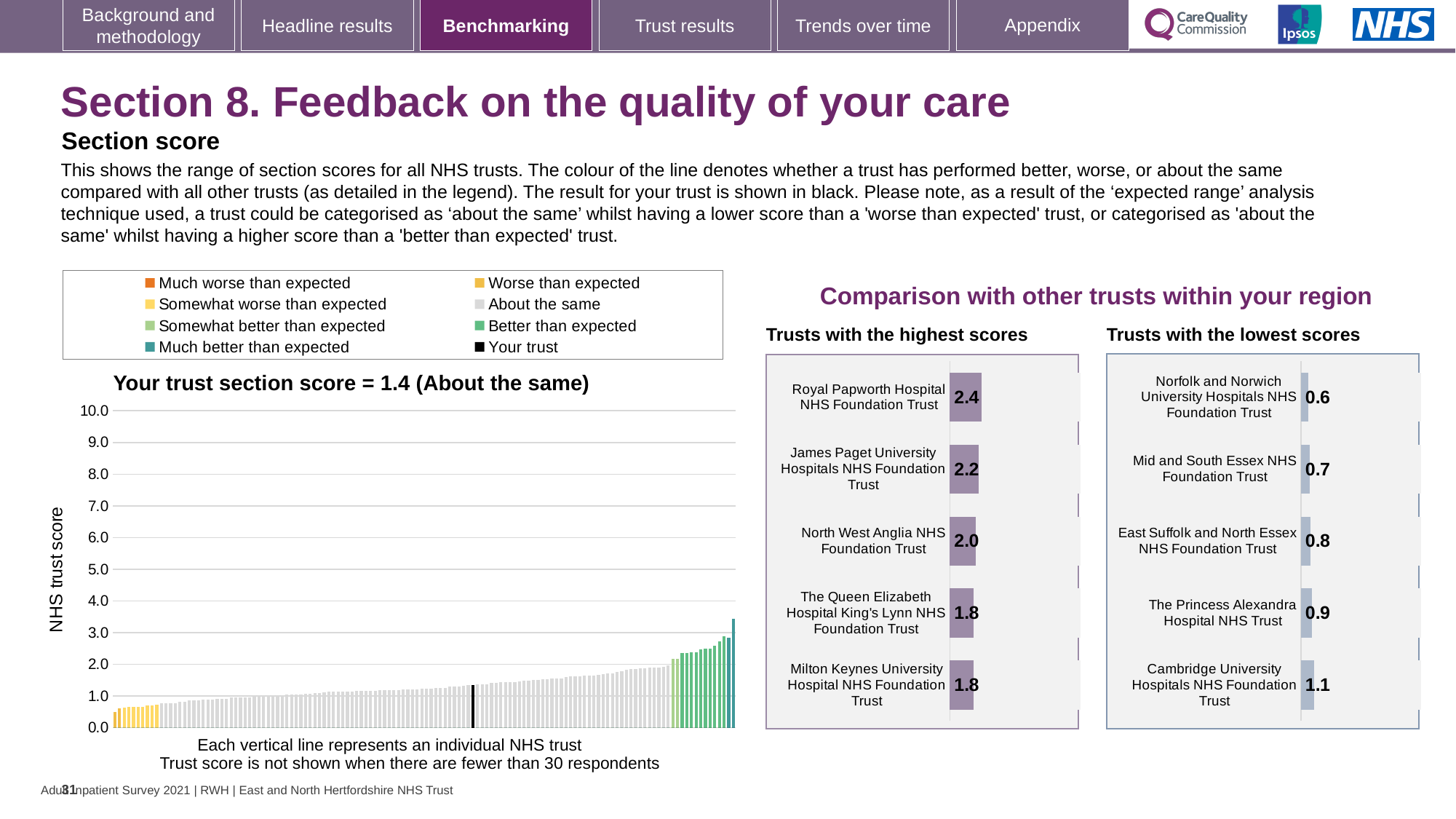
In the 'Trusts with the highest scores' chart, what is the score for Royal Papworth Hospital NHS Foundation Trust? 2.4 In the 'Trusts with the lowest scores' chart, which trust has the lowest score? Norfolk and Norwich University Hospitals NHS Foundation Trust In the 'Trusts with the lowest scores' chart, what is the score for Mid and South Essex NHS Foundation Trust? 0.7 In the main chart on the left, do the trust scores rise or fall from left to right? Rise In the 'Trusts with the highest scores' chart, what is the difference between the scores of Royal Papworth Hospital NHS Foundation Trust and James Paget University Hospitals NHS Foundation Trust? 0.2 In the 'Trusts with the lowest scores' chart, what is the difference between the scores of Cambridge University Hospitals NHS Foundation Trust and Norfolk and Norwich University Hospitals NHS Foundation Trust? 0.5 According to the title of the main chart on the left, what is your trust's section score? 1.4 (About the same) In the 'Trusts with the lowest scores' chart, which has the larger score: East Suffolk and North Essex NHS Foundation Trust or The Princess Alexandra Hospital NHS Trust? The Princess Alexandra Hospital NHS Trust In the 'Trusts with the highest scores' chart, which trust has the highest score? Royal Papworth Hospital NHS Foundation Trust How many trusts are shown in the 'Trusts with the highest scores' chart? 5 What kind of chart is the main chart on the left showing NHS trust scores? Bar chart In the 'Trusts with the highest scores' chart, what is the score for North West Anglia NHS Foundation Trust? 2.0